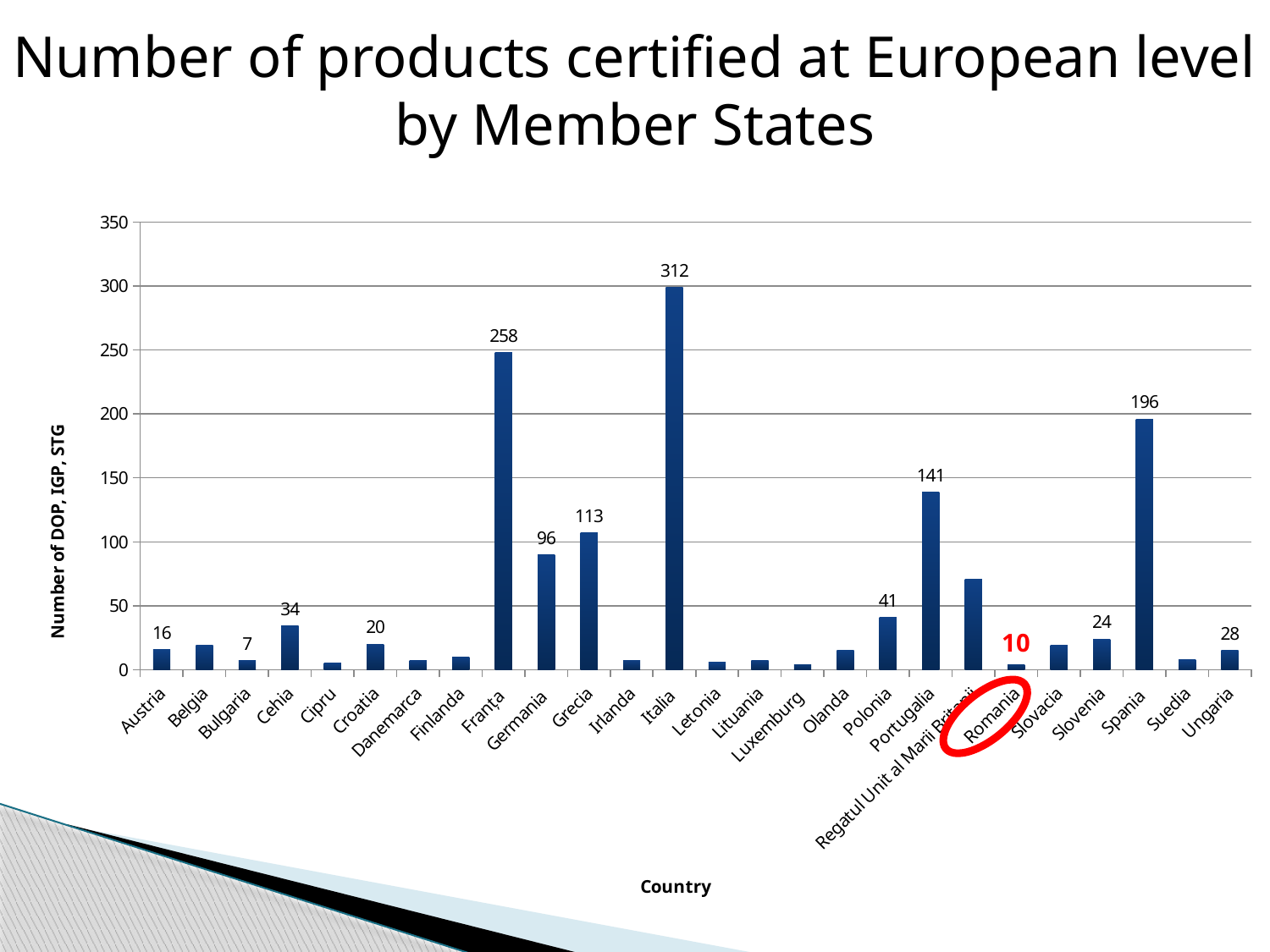
What is the difference between the values for Italia and Franța? 54 What type of chart is shown on the slide? Bar chart What is the difference between the values for Grecia and Germania? 17 Is the value for Regatul Unit al Marii Britanii greater or less than 50? greater How many products certified at European level does Italia have? 312 Is the value for Luxemburg greater or less than 50? less What is the value shown for Grecia? 113 What is the value shown for Franța? 258 What is the value shown for Cehia? 34 How many countries are shown on the x axis of the chart? 26 Which has a larger value, Spania or Portugalia? Spania Which country has the highest number of certified products? Italia